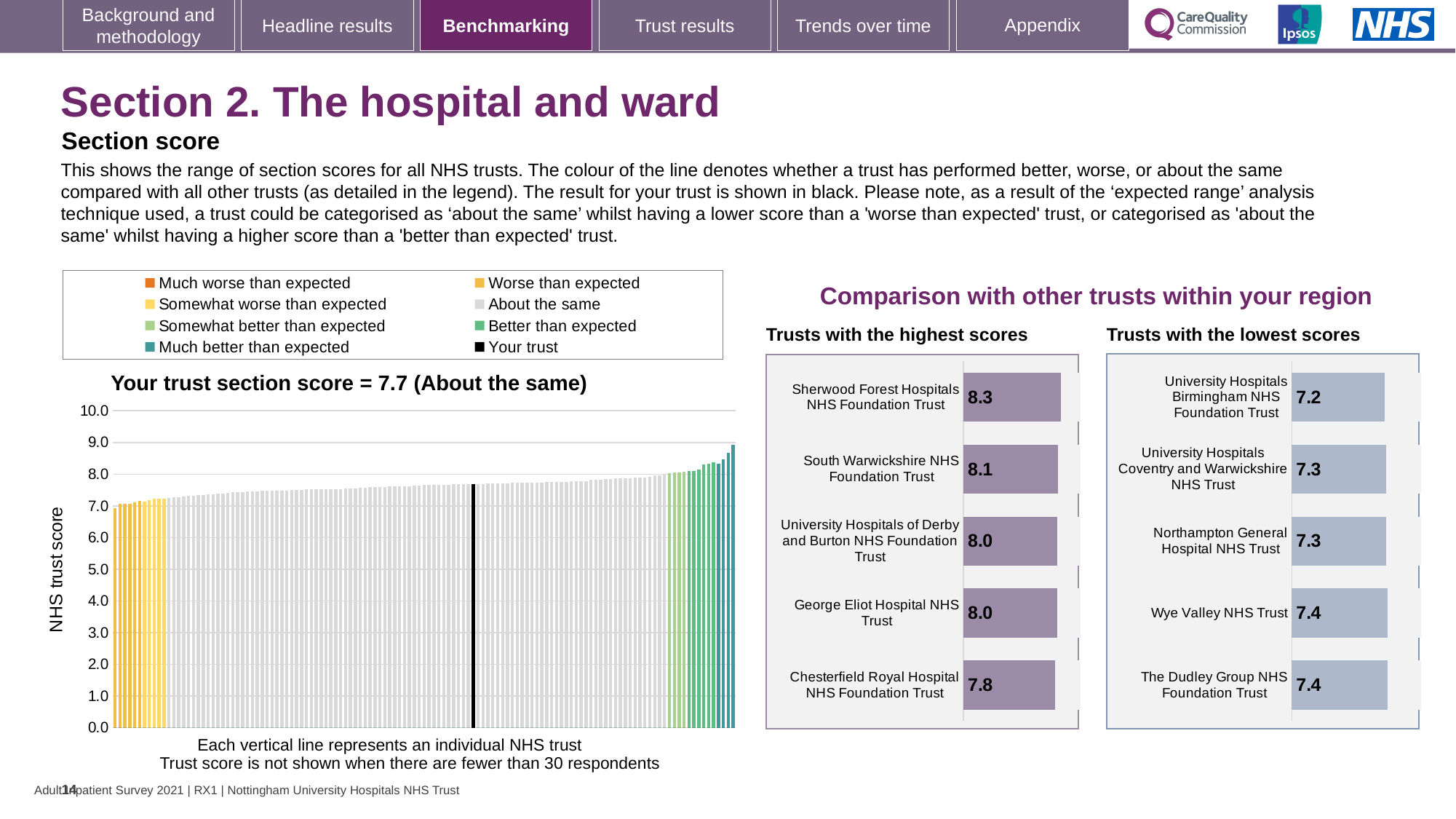
In the 'Trusts with the highest scores' chart, which trust has the highest score? Sherwood Forest Hospitals NHS Foundation Trust In the 'Trusts with the highest scores' chart, what is the difference between the scores of Sherwood Forest Hospitals NHS Foundation Trust and Chesterfield Royal Hospital NHS Foundation Trust? 0.5 Which is larger: the score for South Warwickshire NHS Foundation Trust in the highest scores chart or the score for Northampton General Hospital NHS Trust in the lowest scores chart? South Warwickshire NHS Foundation Trust In the 'Trusts with the highest scores' chart, what is the score for Chesterfield Royal Hospital NHS Foundation Trust? 7.8 In the 'Trusts with the highest scores' chart, what is the score for Sherwood Forest Hospitals NHS Foundation Trust? 8.3 In the 'Trusts with the lowest scores' chart, what is the score for University Hospitals Birmingham NHS Foundation Trust? 7.2 In the 'Your trust section score' chart, do the trust scores rise or fall from left to right along the x axis? rise How many entries does the legend above the 'Your trust section score' chart list? 8 In the 'Trusts with the lowest scores' chart, which trust has the lowest score? University Hospitals Birmingham NHS Foundation Trust In the 'Trusts with the lowest scores' chart, what is the score for Wye Valley NHS Trust? 7.4 How many trusts are shown in the 'Trusts with the lowest scores' chart? 5 In the 'Your trust section score' chart, what is the section score for your trust? 7.7